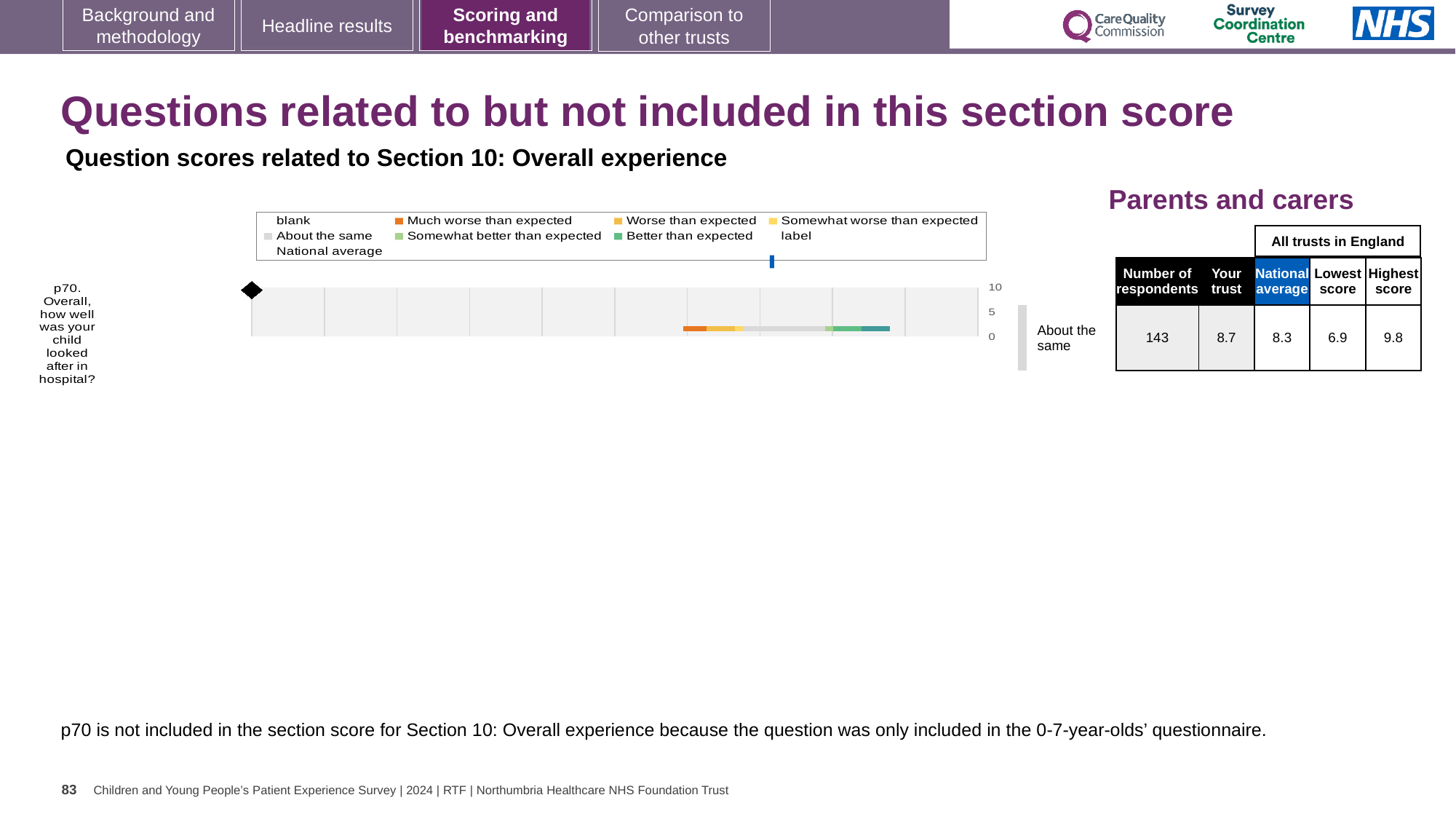
What is the lowest score among all trusts in England for p70? 6.9 What is the highest value shown on the chart's axis? 10 What is the national average score for p70? 8.3 What is the 'Your trust' score for p70 in the Parents and carers table? 8.7 What rating label is shown next to the bar for p70? About the same What is the highest score among all trusts in England for p70? 9.8 Which legend entry is shown in orange? Much worse than expected How many questions (categories) are plotted in the chart? 1 Which is larger for p70: the 'Your trust' score or the national average? Your trust What is the difference between the highest score and the lowest score for p70? 2.9 How many respondents answered p70? 143 What kind of chart is used to show the p70 question score? bar chart